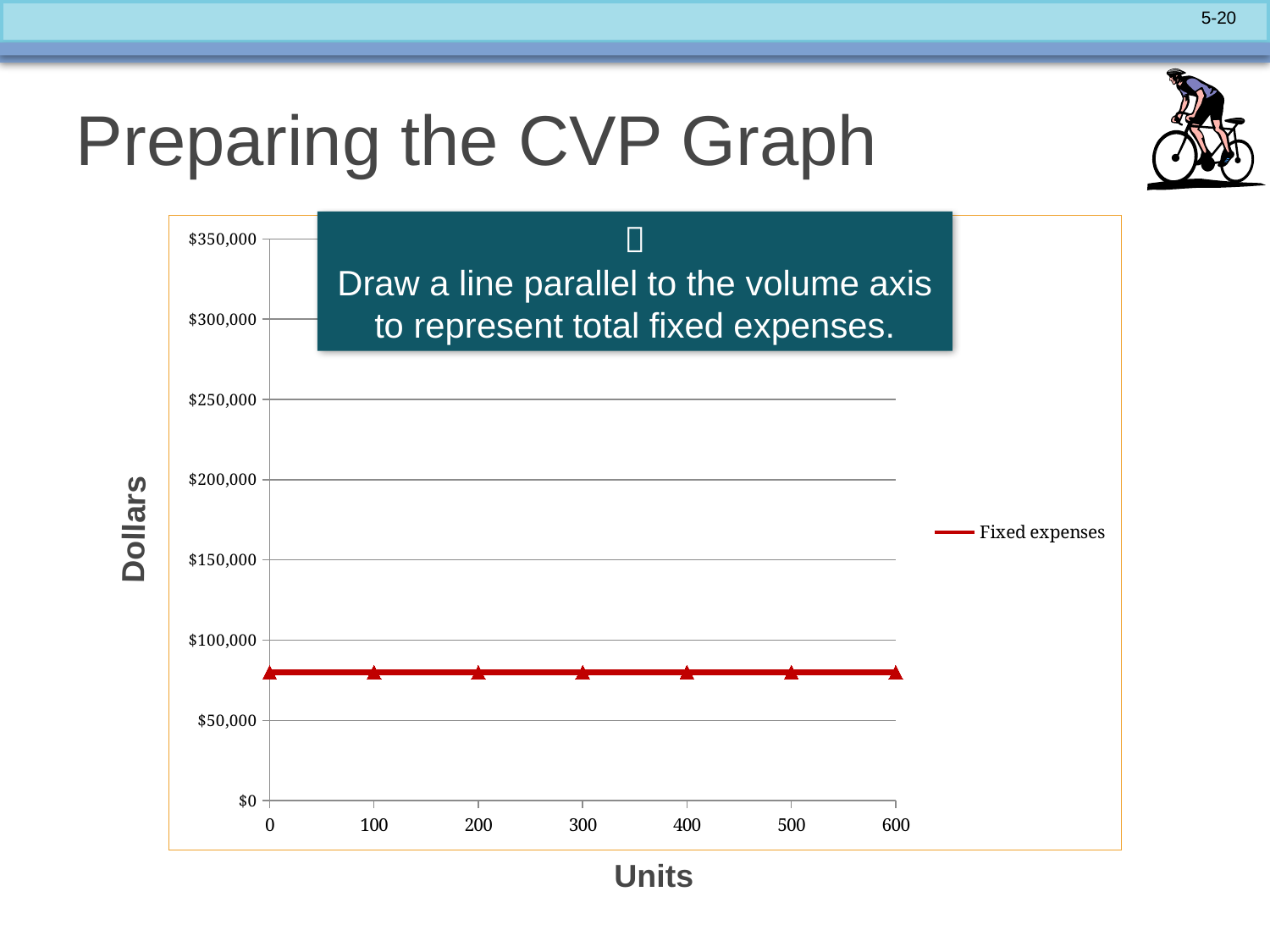
How many data points are plotted on the Fixed expenses line? 7 What is the title of the vertical axis? Dollars Is the value for Fixed expenses at 600 units greater or less than $50,000? greater Is the value for Fixed expenses at 0 units greater or less than $150,000? less How many series does the legend list? 1 Do the Fixed expenses values rise, fall, or stay flat as units increase along the x axis? stay flat What is the name of the series shown in the legend? Fixed expenses What kind of chart is shown on the slide? line chart Is the value for Fixed expenses at 300 units greater or less than $100,000? less What is the largest unit value shown on the horizontal axis? 600